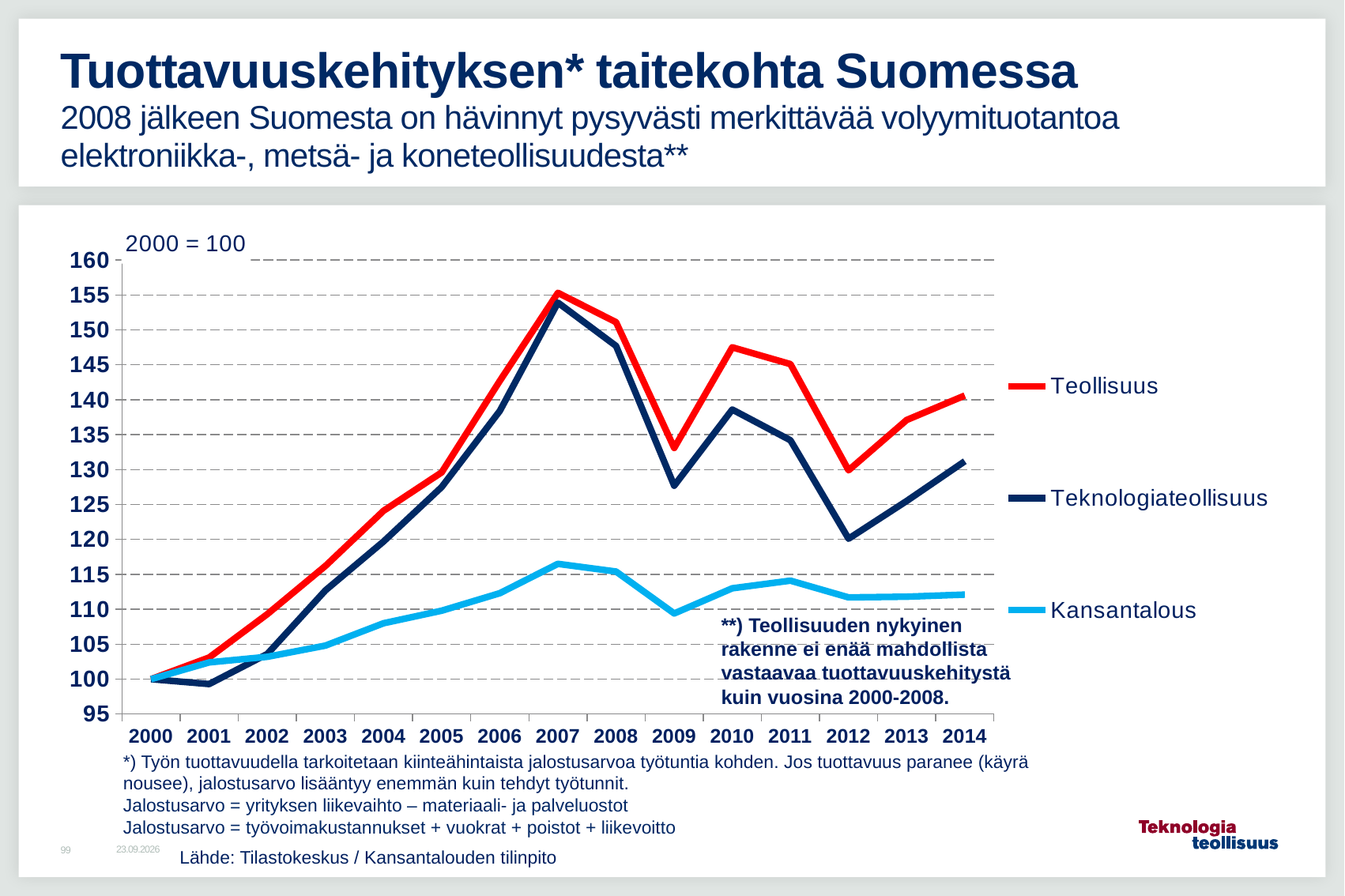
In which year does the Kansantalous line reach its highest value? 2007 Which series has the lowest value in 2014? Kansantalous Which is larger in 2012, Teollisuus or Teknologiateollisuus? Teollisuus Is the value for Teknologiateollisuus in 2009 greater or less than 125? greater Is the value for Teollisuus in 2007 greater or less than 150? greater Which series has the highest value in 2014? Teollisuus Is the value for Kansantalous in 2014 greater or less than 110? greater In which year does the Teollisuus line reach its highest value? 2007 How many series does the legend list? 3 How many years are shown on the x axis? 15 What is the value of Teollisuus in 2000? 100 What kind of chart is shown on the slide? line chart